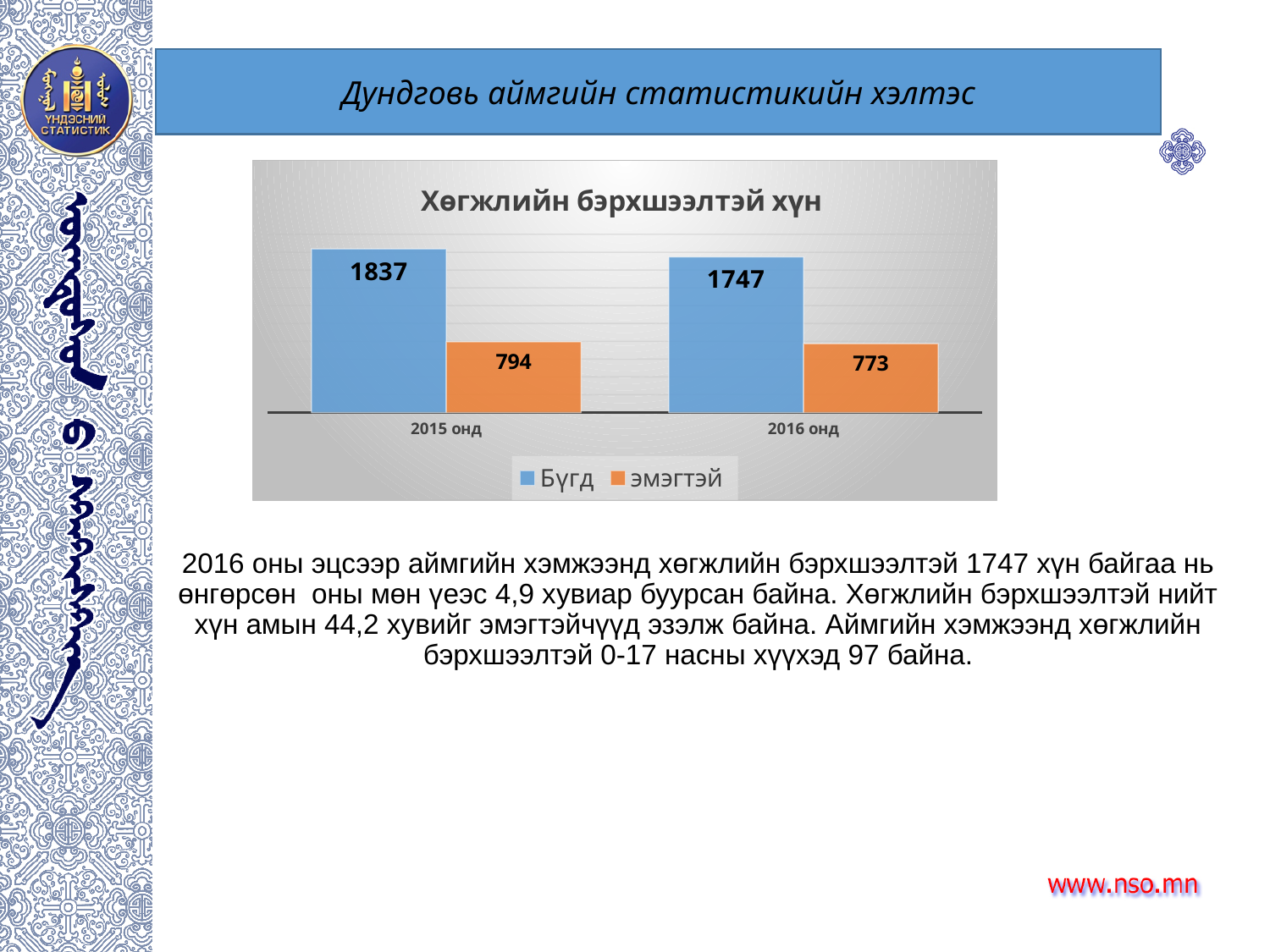
How many categories are shown on the x axis? 2 What is the difference between Бүгд and эмэгтэй for 2016 онд? 974 What type of chart is shown? bar chart What is the value of Бүгд for 2016 онд? 1747 Which is larger: эмэгтэй for 2015 онд or эмэгтэй for 2016 онд? 2015 онд How many series does the legend list? 2 What is the value of эмэгтэй for 2015 онд? 794 What is the difference between the Бүгд values for 2015 онд and 2016 онд? 90 Which category has the highest Бүгд value? 2015 онд Which category has the lowest эмэгтэй value? 2016 онд What is the value of эмэгтэй for 2016 онд? 773 What is the value of Бүгд for 2015 онд? 1837